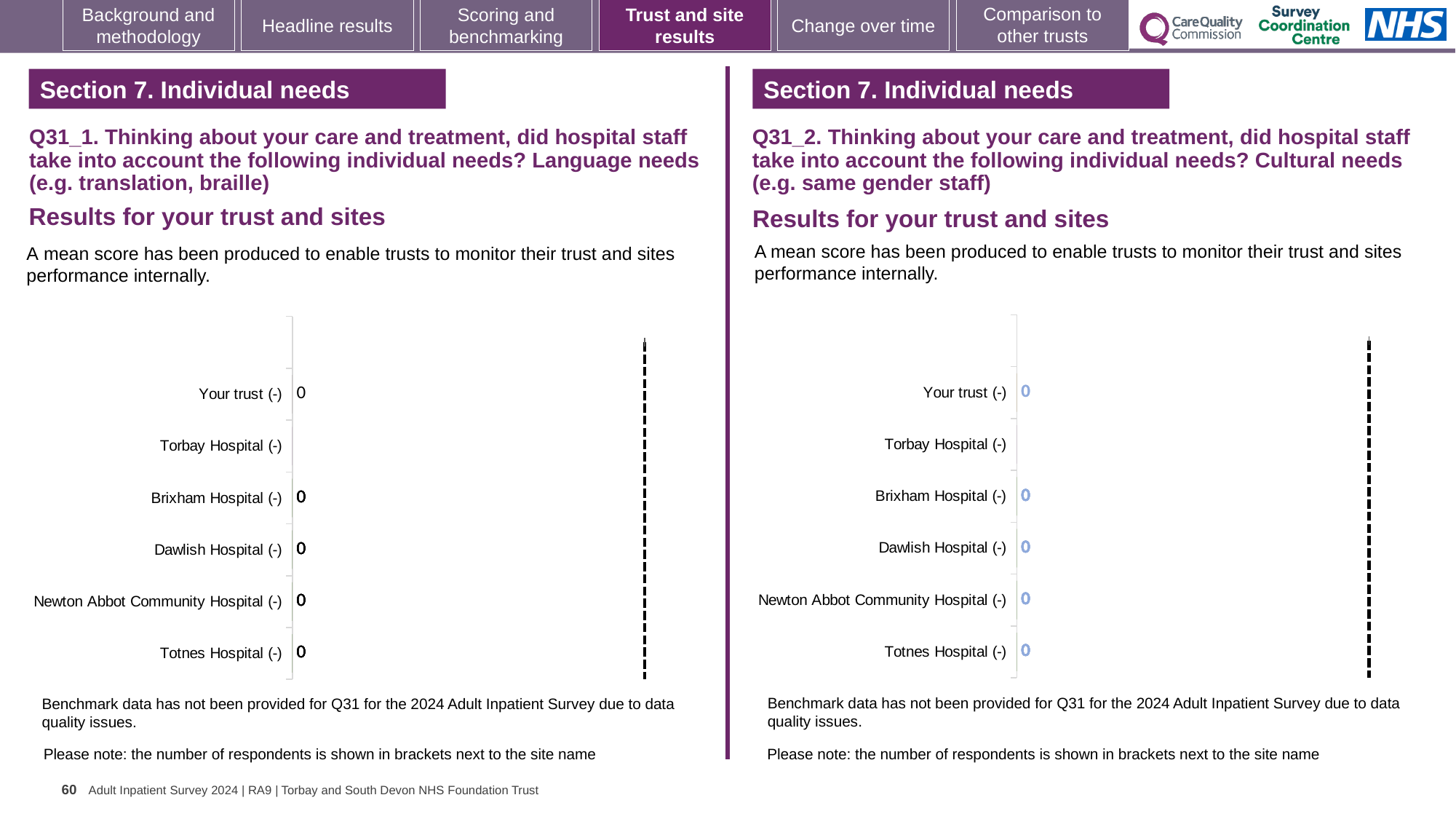
On the right chart (Q31_2, Cultural needs), what is the value shown for Totnes Hospital (-)? 0 On the left chart (Q31_1, Language needs), which category has no data label shown next to it? Torbay Hospital (-) On the left chart (Q31_1, Language needs), what is the value shown for Your trust (-)? 0 On the right chart (Q31_2, Cultural needs), what is the difference between the value for Your trust (-) and the value for Newton Abbot Community Hospital (-)? 0 Which category appears at the top of the right chart (Q31_2, Cultural needs)? Your trust (-) On the right chart (Q31_2, Cultural needs), what is the value shown for Brixham Hospital (-)? 0 How many categories are listed on the right chart (Q31_2, Cultural needs)? 6 On the left chart (Q31_1, Language needs), what is the value shown for Dawlish Hospital (-)? 0 On the left chart (Q31_1, Language needs), what is the value shown for Newton Abbot Community Hospital (-)? 0 What kind of chart is used on the left side of the slide (Q31_1, Language needs)? Bar chart How many categories are listed on the left chart (Q31_1, Language needs)? 6